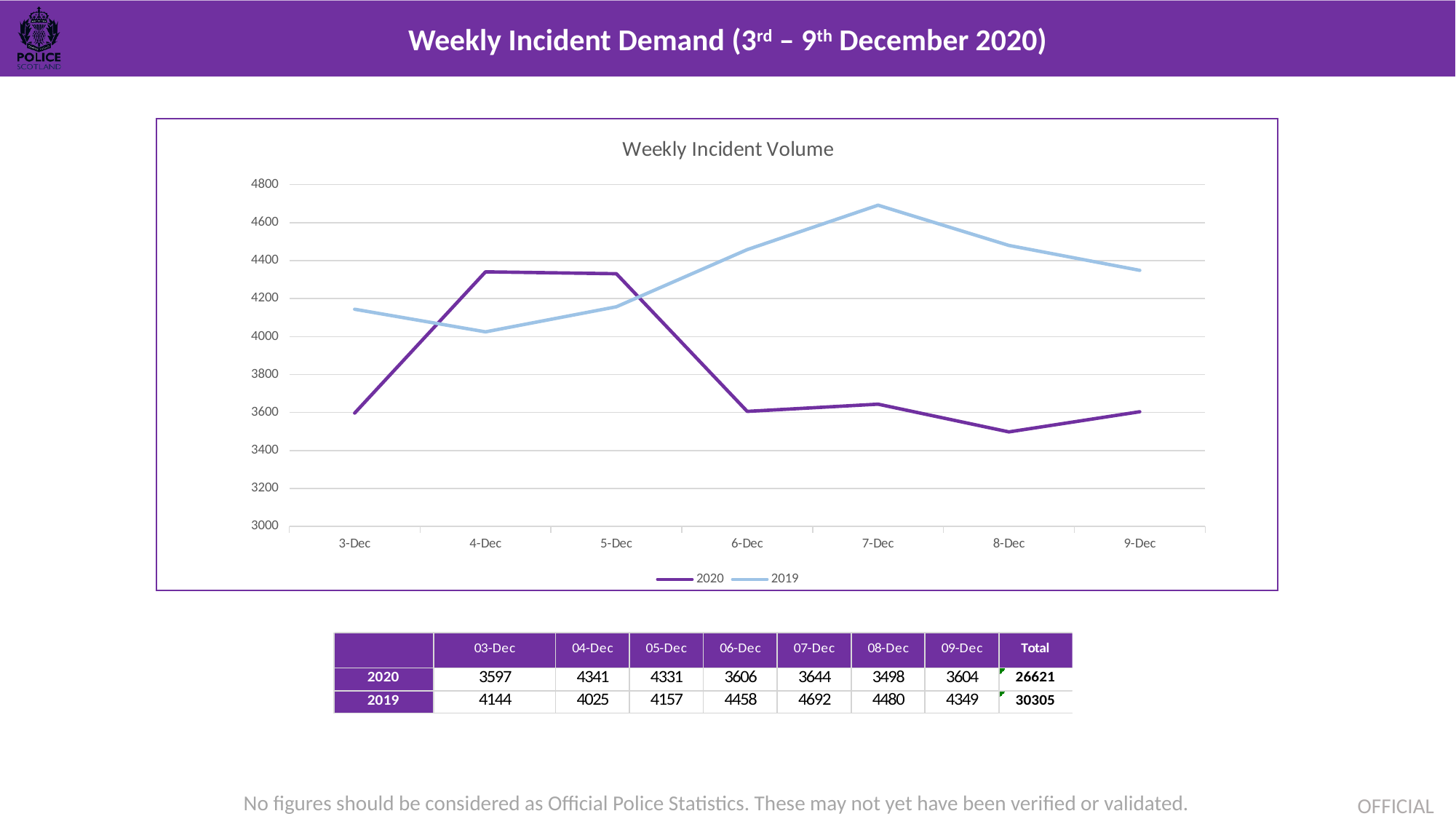
How many series does the legend list? 2 What is the title of the chart? Weekly Incident Volume On which date is the 2019 incident volume highest? 7-Dec What kind of chart is shown on the slide? line chart Which series has the higher value on 4-Dec, 2020 or 2019? 2020 How many dates are plotted along the x axis? 7 Does the 2020 line rise or fall from 5-Dec to 6-Dec? fall Is the 2020 value on 6-Dec greater or less than 4000? less What is the 2020 incident volume on 4-Dec? 4341 What is the difference between the 2019 and 2020 values on 7-Dec? 1048 What is the 2019 incident volume on 7-Dec? 4692 On which date is the 2020 incident volume lowest? 8-Dec